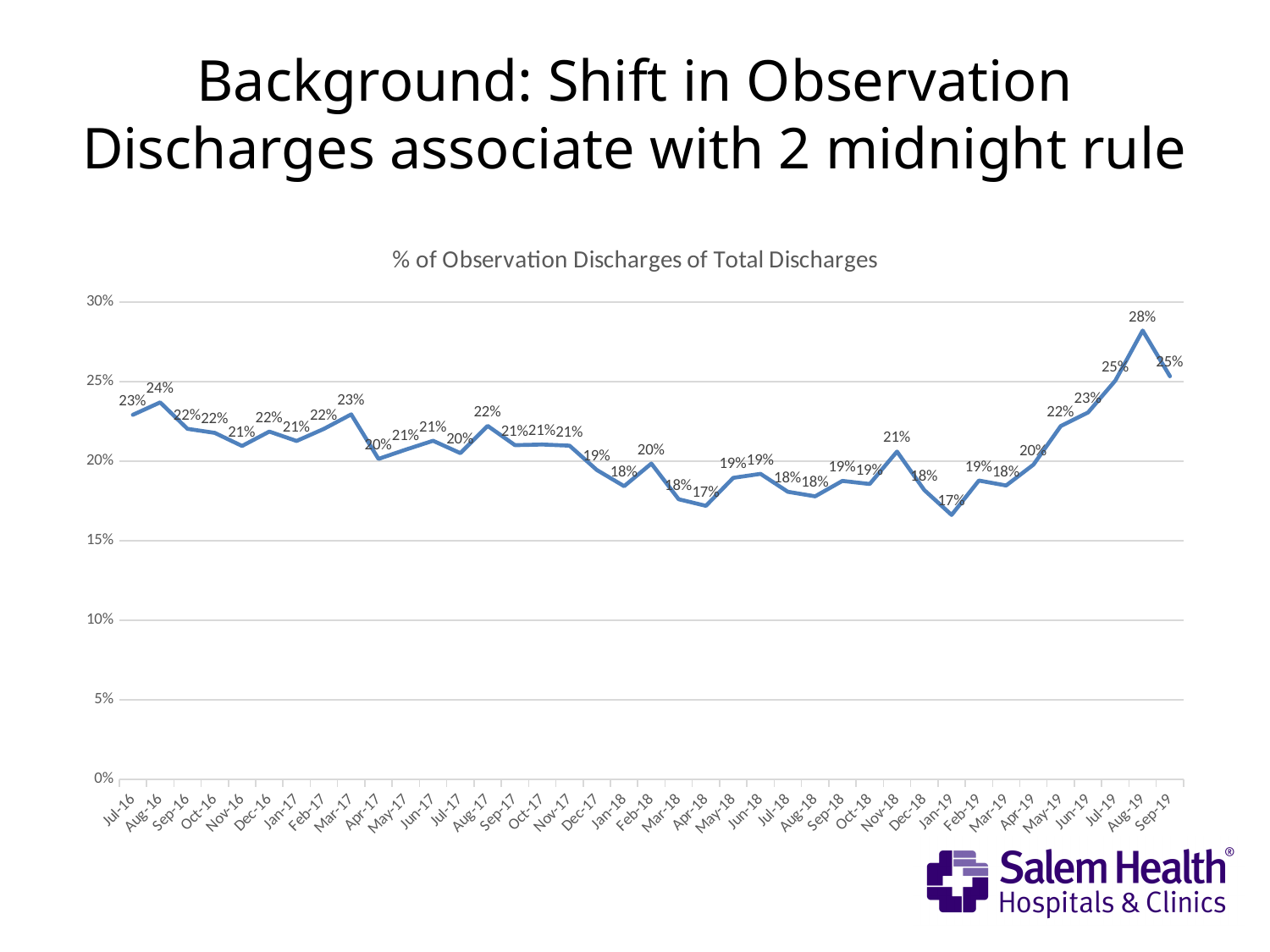
Is the value for Aug-19 greater or less than 25%? greater Do the values rise or fall from Jan-19 to Aug-19? rise What is the value for Nov-18? 21% What kind of chart is shown on the slide? line chart What is the value for Sep-19? 25% What is the value for Aug-19? 28% What is the lowest value shown on the chart? 17% Which month has the highest value? Aug-19 What is the value for Jul-16? 23% What is the chart's title? % of Observation Discharges of Total Discharges What is the difference between the value for Aug-19 and the value for Jul-16? 5 percentage points Which is larger, the value for Aug-16 or the value for Apr-18? Aug-16